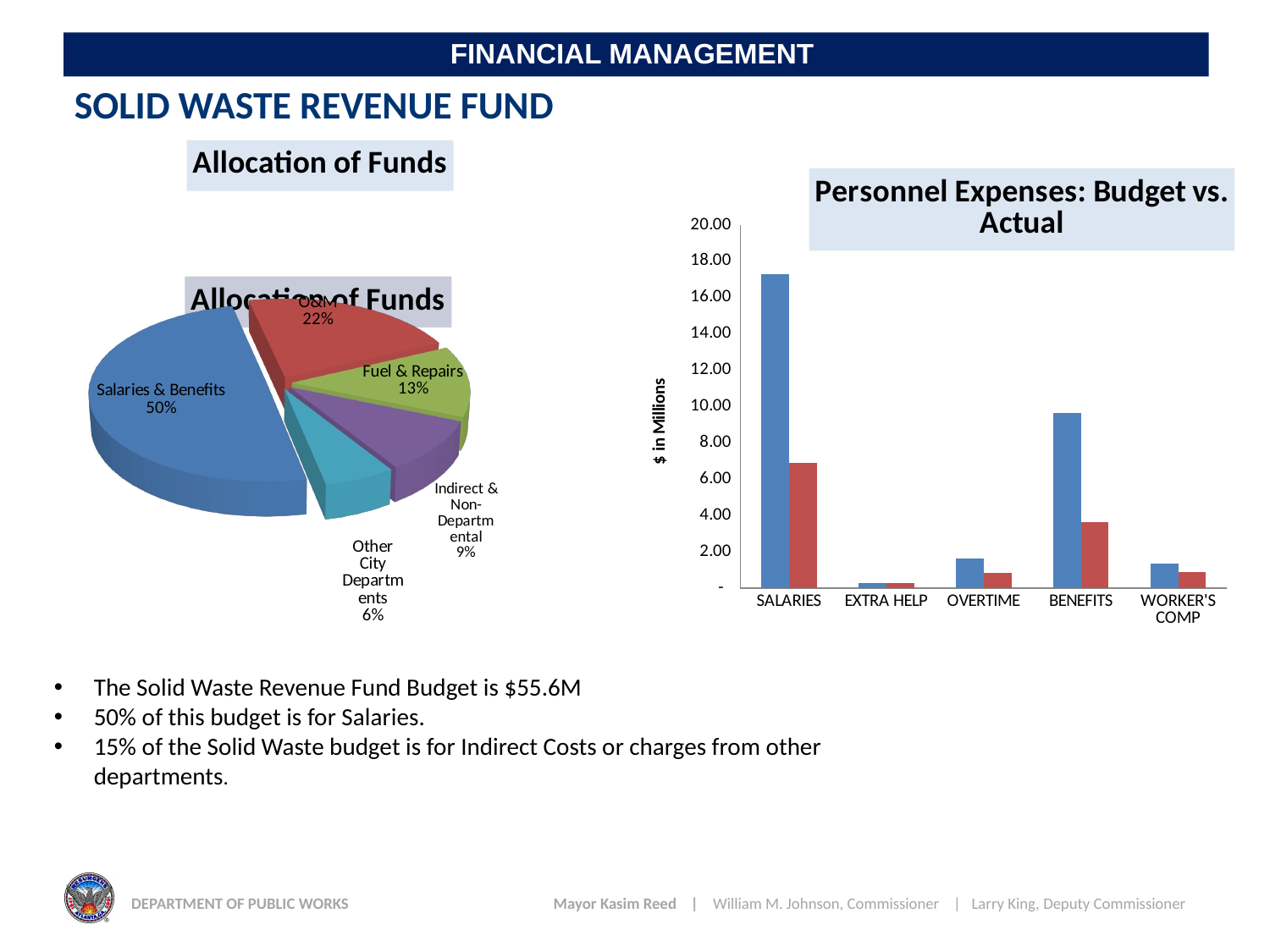
In the Allocation of Funds pie chart, what percentage is allocated to Fuel & Repairs? 13% In the Allocation of Funds pie chart, what percentage is allocated to O&M? 22% In the Allocation of Funds pie chart, what share of funds goes to Salaries & Benefits? 50% How many slices does the Allocation of Funds pie chart have? 5 In the Personnel Expenses: Budget vs. Actual chart, is the blue bar for SALARIES greater or less than 16.00? greater In the Allocation of Funds pie chart, how many percentage points larger is O&M than Fuel & Repairs? 9 percentage points In the Personnel Expenses: Budget vs. Actual chart, which category has the tallest blue bar? SALARIES In the Allocation of Funds pie chart, which category has the largest slice? Salaries & Benefits In the Allocation of Funds pie chart, which category has the smallest slice? Other City Departments In the Personnel Expenses: Budget vs. Actual chart, is the red bar for BENEFITS greater or less than 2.00? greater What type of chart is the Personnel Expenses: Budget vs. Actual chart? Bar chart How many categories are shown on the x axis of the Personnel Expenses: Budget vs. Actual chart? 5